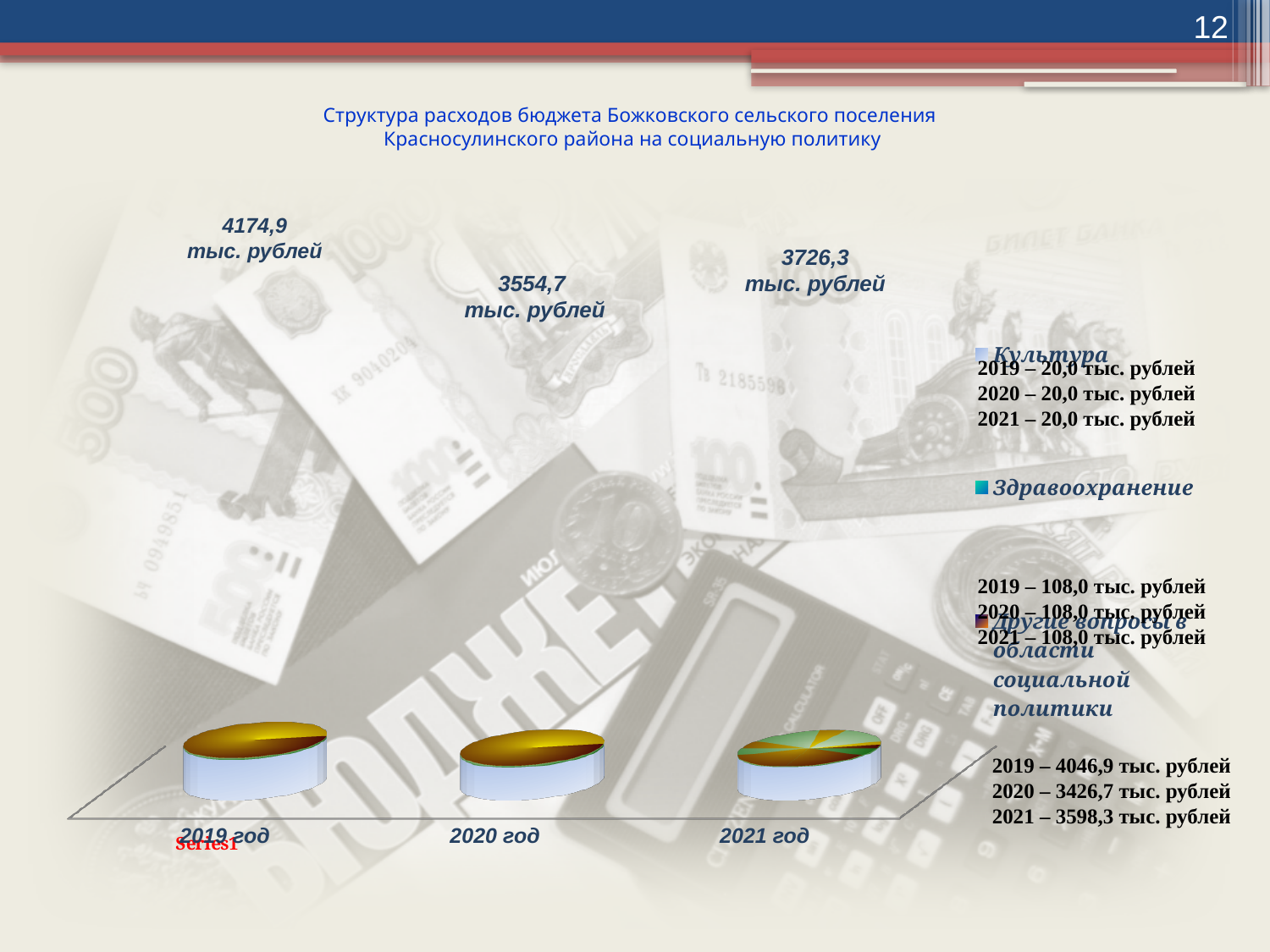
What is the total social policy expenditure shown above the 2019 год pie chart? 4174,9 тыс. рублей What is the value for Другие вопросы в области социальной политики in 2019? 4046,9 тыс. рублей Which year has the highest total social policy expenditure? 2019 год How many categories does the legend list? 3 What is the value for Здравоохранение in 2020 according to the slide? 108,0 тыс. рублей What is the total social policy expenditure shown above the 2021 год pie chart? 3726,3 тыс. рублей How many pie charts are shown on the slide? 3 Which year has the lowest total social policy expenditure? 2020 год Is the value for Другие вопросы в области социальной политики larger in 2020 or in 2021? 2021 What is the total social policy expenditure shown above the 2020 год pie chart? 3554,7 тыс. рублей What is the value for Культура in 2021 according to the slide? 20,0 тыс. рублей What is the difference between the 2019 and 2020 total social policy expenditures? 620,2 тыс. рублей